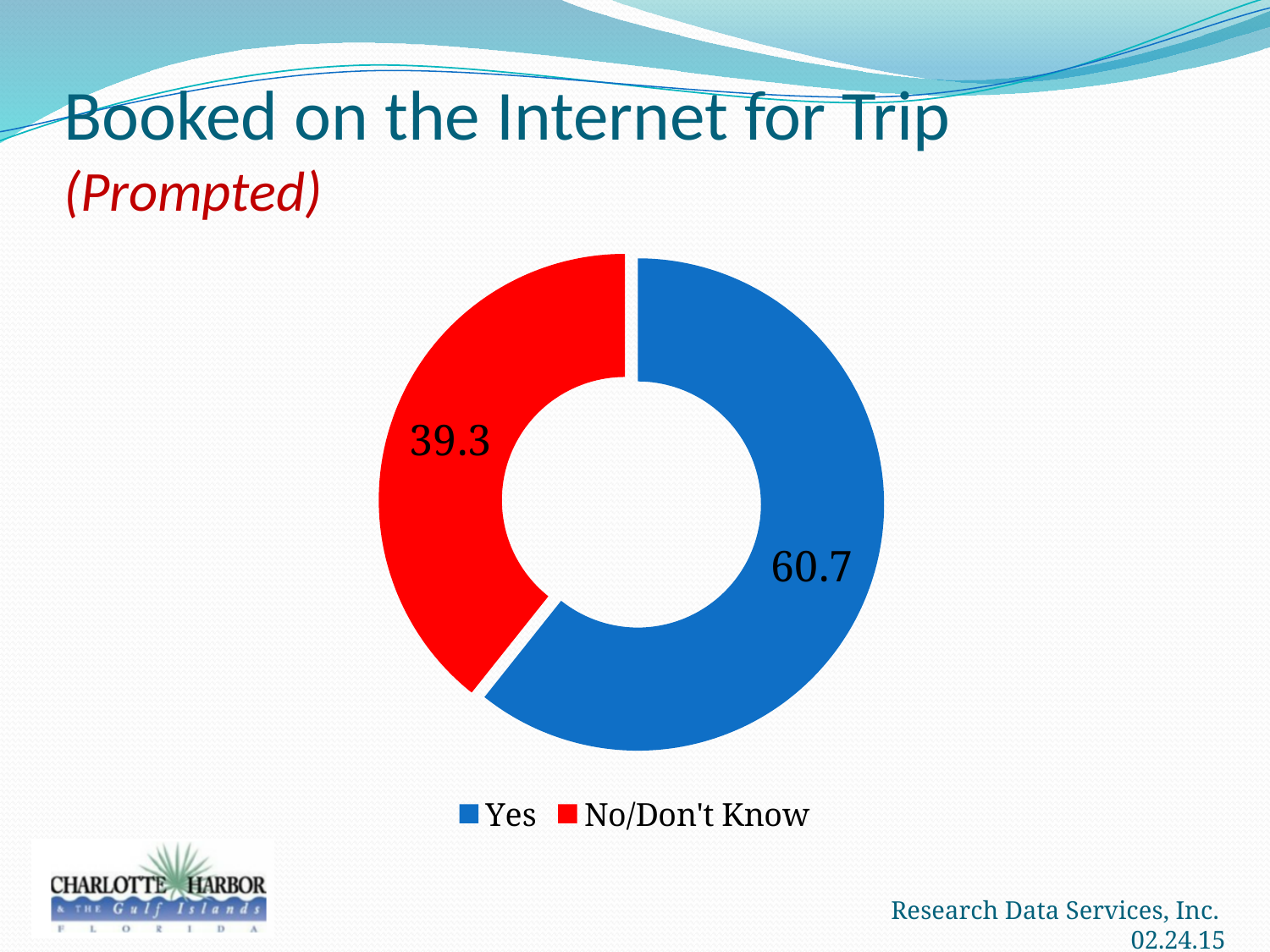
Which category has the smallest slice? No/Don't Know What kind of chart is shown on the slide? Doughnut (pie) chart What colour is the Yes slice? Blue What value is shown for the No/Don't Know slice? 39.3 What is the difference between the Yes value and the No/Don't Know value? 21.4 Which is larger, the Yes slice or the No/Don't Know slice? Yes Which category has the largest slice? Yes How many slices does the chart have? 2 How many entries does the legend list? 2 What is the total of the two slice values? 100 What value is shown for the Yes slice? 60.7 What is the title of the slide? Booked on the Internet for Trip (Prompted)